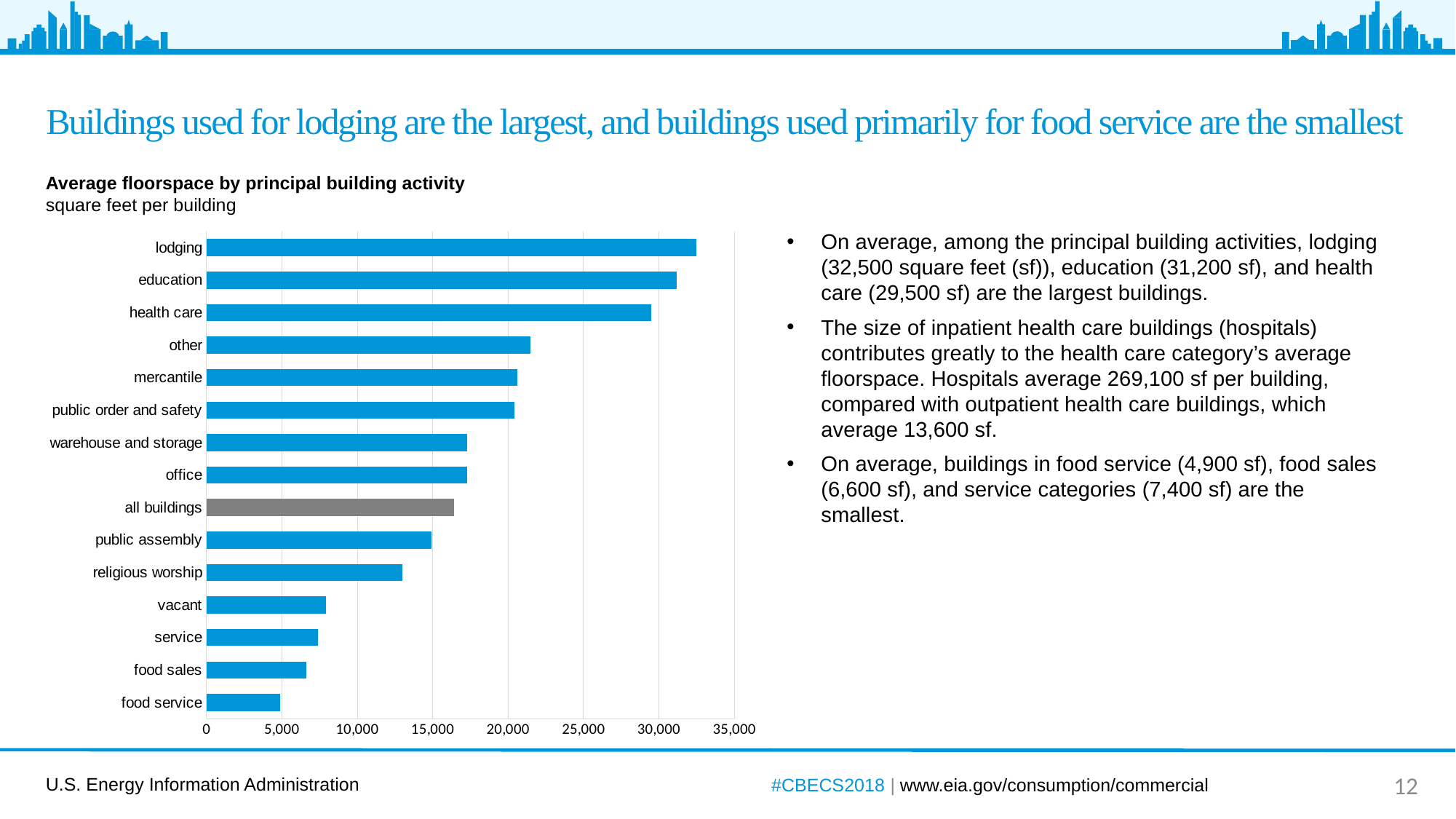
What is the average floorspace per building for food service? 4,900 square feet Is the value for vacant greater or less than 10,000? less Which bar in the chart is coloured gray instead of blue? all buildings What is the difference between the average floorspace of lodging and education buildings? 1,300 square feet What kind of chart is shown on the slide? bar chart Which principal building activity has the largest average floorspace? lodging Which principal building activity has the smallest average floorspace? food service Is the value for warehouse and storage greater or less than 15,000? greater How many categories are plotted in the chart? 15 Which has a larger average floorspace, public assembly or religious worship? public assembly What is the average floorspace per building for lodging? 32,500 square feet Is the value for 'other' greater or less than 20,000? greater